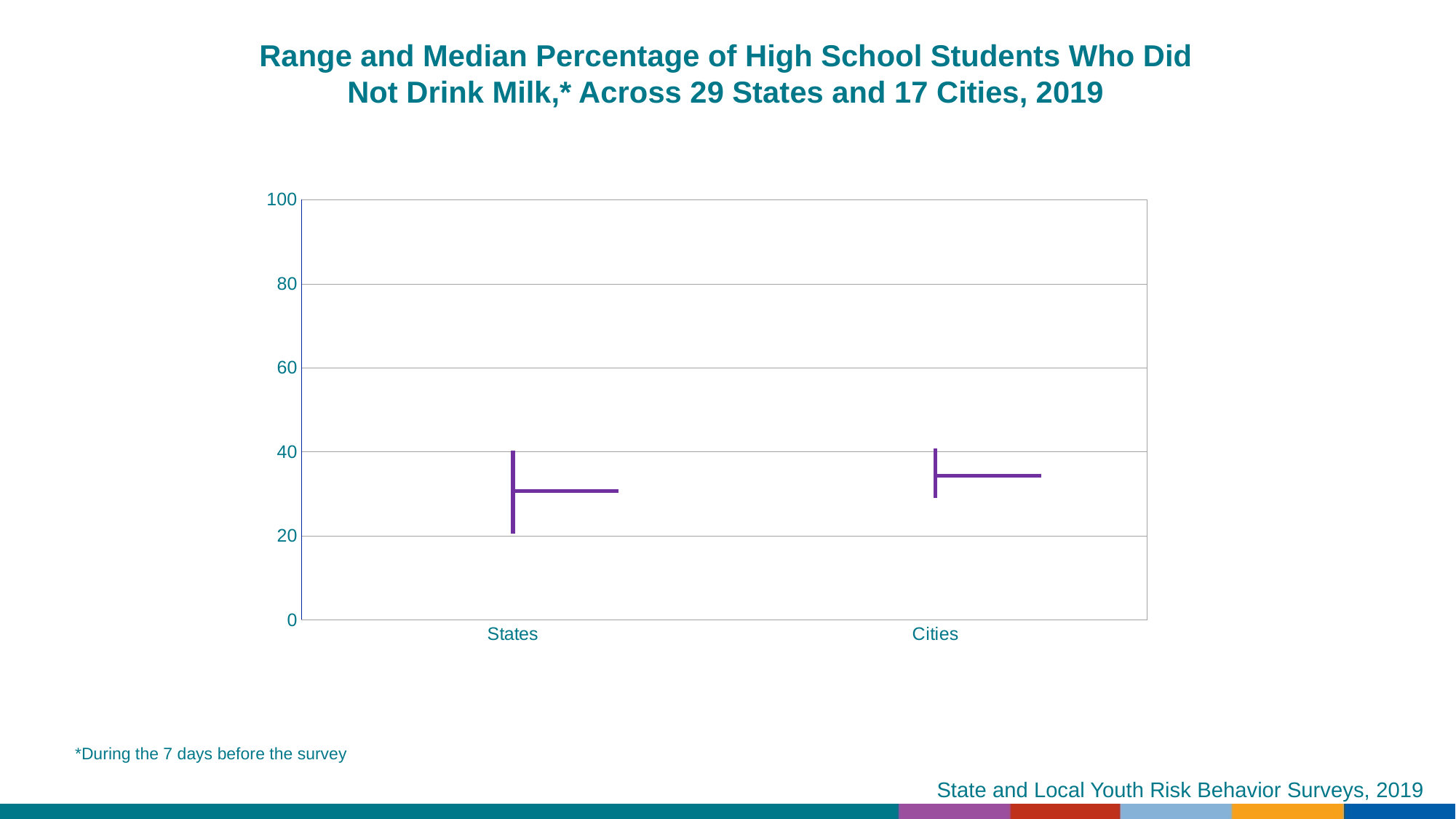
Is the lowest value in the range for Cities greater or less than 20? greater Is the median value for States greater or less than 40? less What are the two categories shown on the x axis? States and Cities Is the median value for Cities greater or less than 20? greater What is the title of the chart? Range and Median Percentage of High School Students Who Did Not Drink Milk,* Across 29 States and 17 Cities, 2019 How many categories are shown on the x axis? 2 Which category has the wider range, States or Cities? States Which category has the higher median, States or Cities? Cities What is the maximum value shown on the y axis? 100